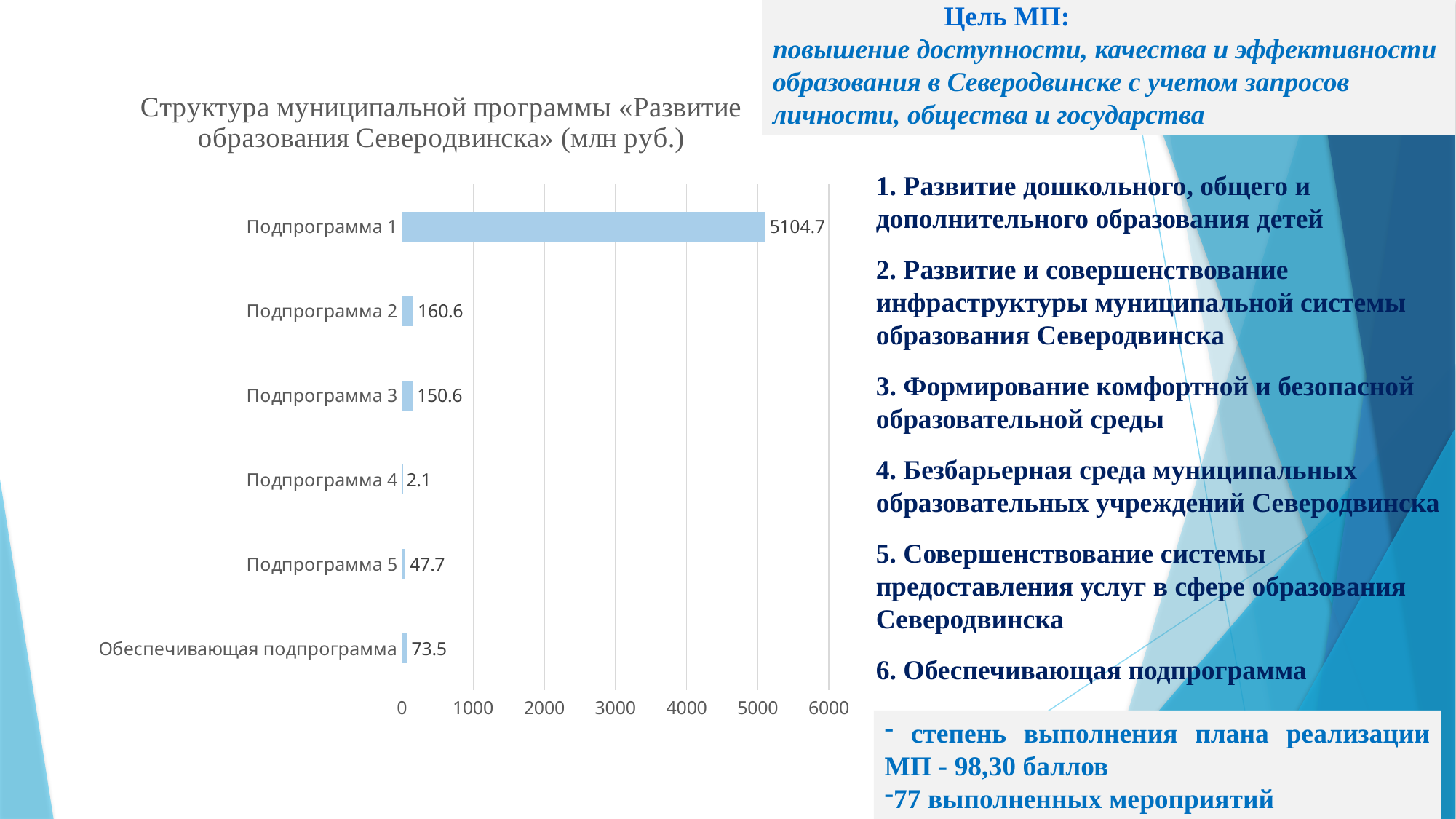
What kind of chart is shown on the slide? bar chart What unit is given in the chart title? млн руб. What is the difference between the values for Подпрограмма 2 and Подпрограмма 3? 10 What is the value for Подпрограмма 1? 5104.7 Which is larger, the value for Подпрограмма 5 or the value for Обеспечивающая подпрограмма? Обеспечивающая подпрограмма What is the value for Подпрограмма 4? 2.1 How many categories are shown in the chart? 6 Is the value for Подпрограмма 1 greater or less than 5000? greater What is the value for Обеспечивающая подпрограмма? 73.5 What is the value for Подпрограмма 2? 160.6 Which category has the lowest value? Подпрограмма 4 Which category has the highest value? Подпрограмма 1